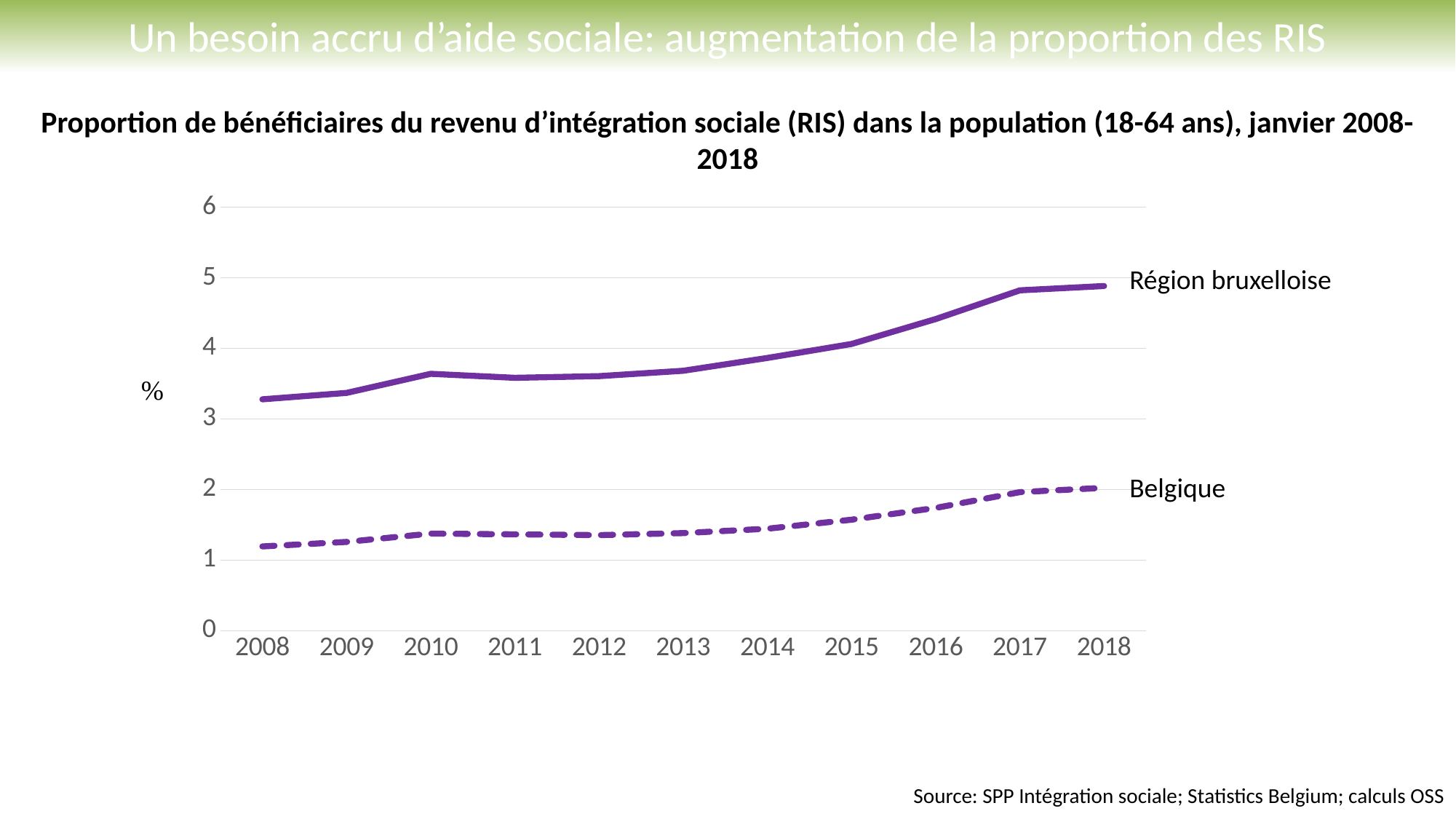
Is the value for Région bruxelloise in 2008 greater or less than 3? greater What kind of chart is shown on the slide? line chart Is the value for Région bruxelloise in 2012 greater or less than 4? less Is the value for Région bruxelloise in 2018 greater or less than 4? greater Do the values for Belgique rise or fall between 2008 and 2018? rise In 2018, which series has the larger value, Région bruxelloise or Belgique? Région bruxelloise Do the values for Région bruxelloise rise or fall between 2008 and 2018? rise In which year is the value for Région bruxelloise lowest? 2008 How many series are plotted on the chart? 2 What unit is shown on the y axis label? % How many years are shown along the x axis? 11